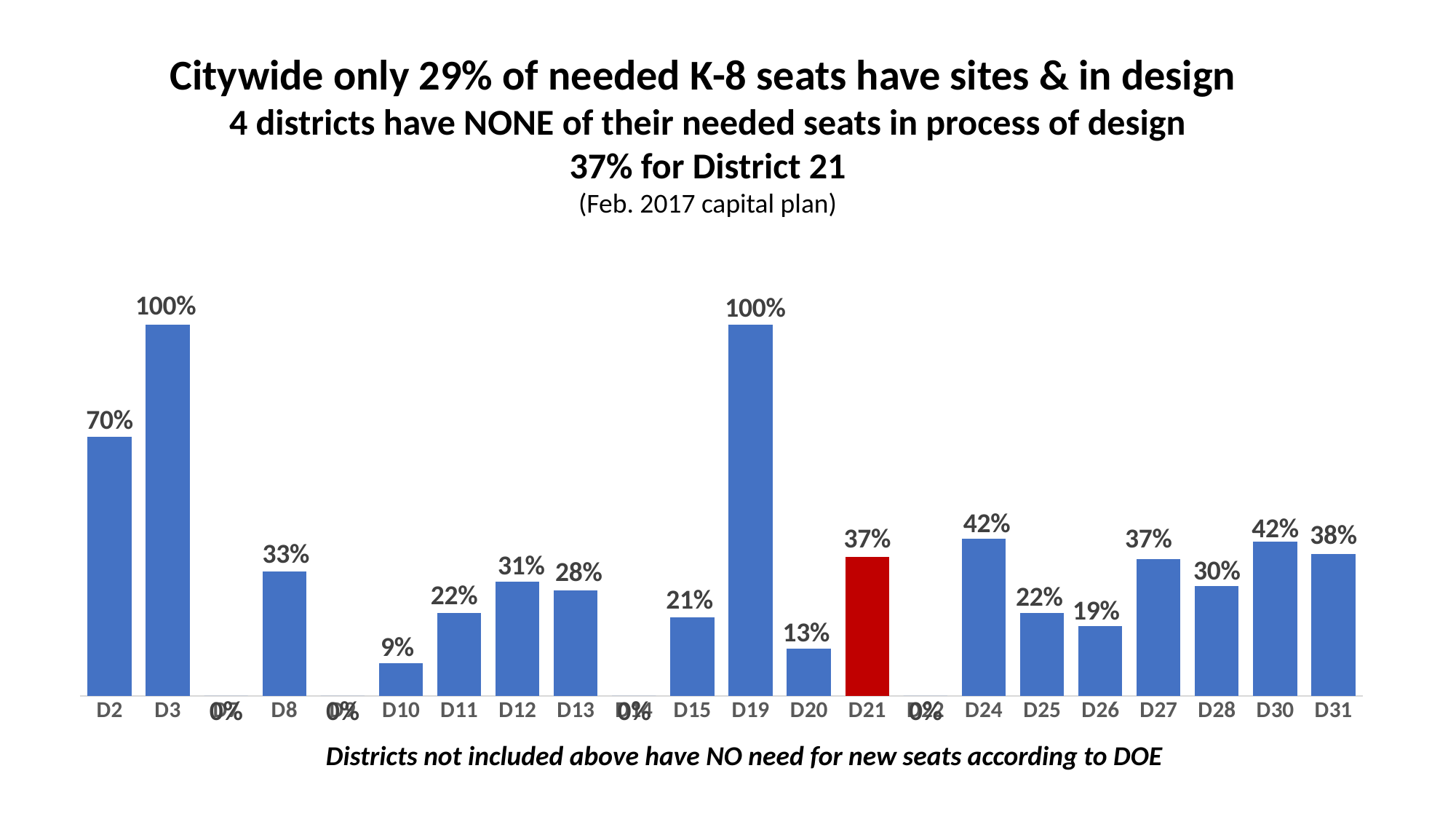
What is the highest value shown on the chart? 100% Which has the larger value, D27 or D28? D27 What is the difference between the values for D3 and D2? 30% Which district's bar is coloured red? D21 What kind of chart is shown on the slide? Bar chart What is the difference between the values for D31 and D20? 25% What is the value for D10? 9% Which has the larger value, D12 or D13? D12 What is the value for D21? 37% What is the value for D26? 19% What is the value for D24? 42% How many districts on the chart have a value of 0%? 4